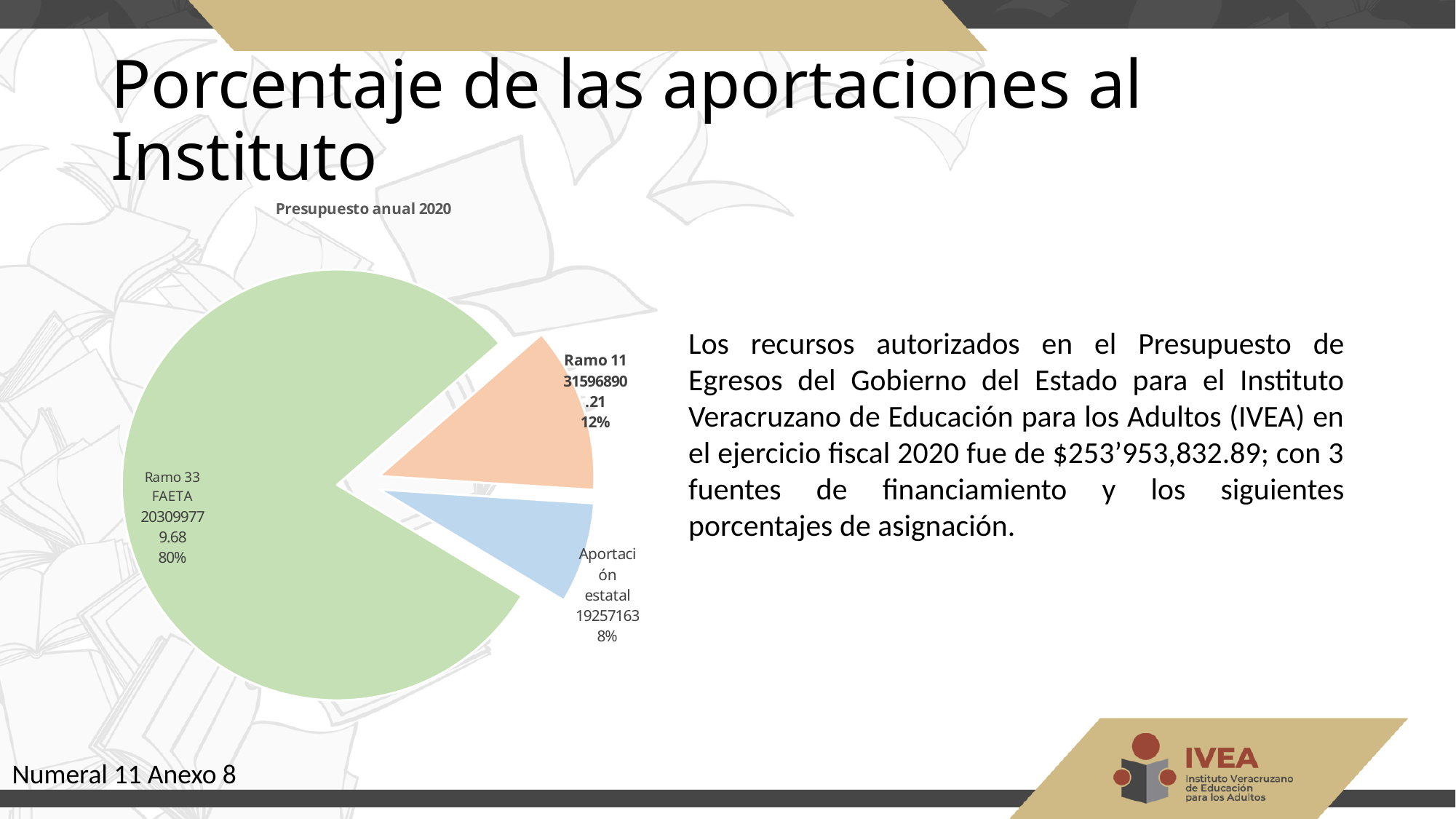
What colour is the Ramo 33 FAETA slice? Green What share of the pie does Ramo 33 FAETA represent? 80% What is the title of the chart? Presupuesto anual 2020 What share of the pie does Ramo 11 represent? 12% What is the difference in percentage points between the share of Ramo 33 FAETA and the share of Ramo 11? 68% What is the value shown for Aportación estatal? 19257163 What kind of chart is shown on the slide? Pie chart Which is larger, the share for Ramo 11 or the share for Aportación estatal? Ramo 11 Which slice of the pie is the largest? Ramo 33 FAETA What share of the pie does Aportación estatal represent? 8% How many slices does the pie chart have? 3 Which slice of the pie is the smallest? Aportación estatal